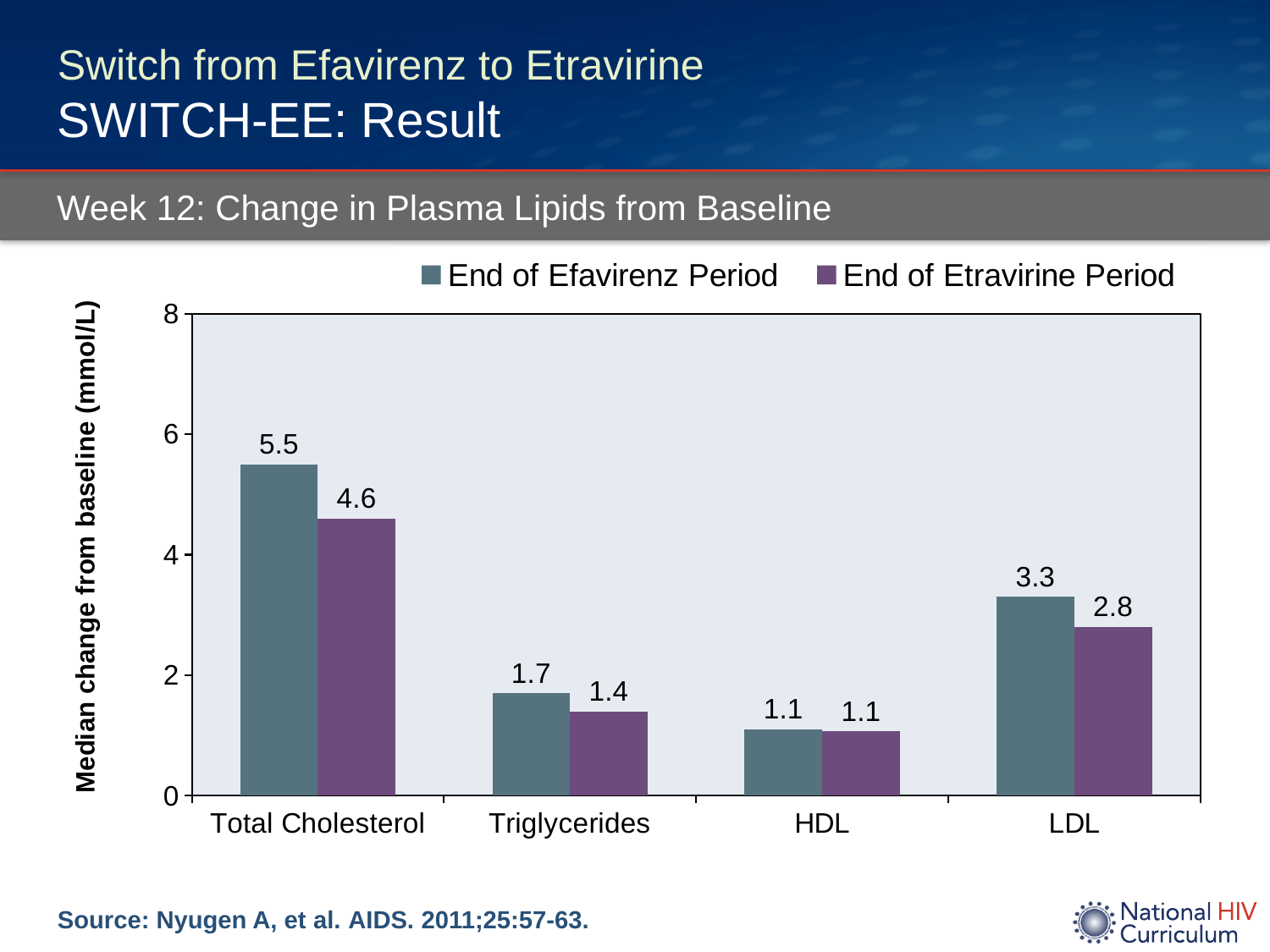
What is the value for Triglycerides at the End of Efavirenz Period? 1.7 What is the value for LDL at the End of Etravirine Period? 2.8 Which category has the highest value at the End of Etravirine Period? Total Cholesterol What is the difference between the End of Efavirenz Period and End of Etravirine Period values for Total Cholesterol? 0.9 Which is larger for Triglycerides: the End of Efavirenz Period value or the End of Etravirine Period value? End of Efavirenz Period Which category has the lowest value at the End of Efavirenz Period? HDL What is the value for Total Cholesterol at the End of Efavirenz Period? 5.5 How many lipid categories are shown on the x axis? 4 How many series does the legend list? 2 What kind of chart is shown on the slide? bar chart Is the value for LDL at the End of Efavirenz Period greater or less than 4? less What is the difference between the End of Efavirenz Period and End of Etravirine Period values for LDL? 0.5